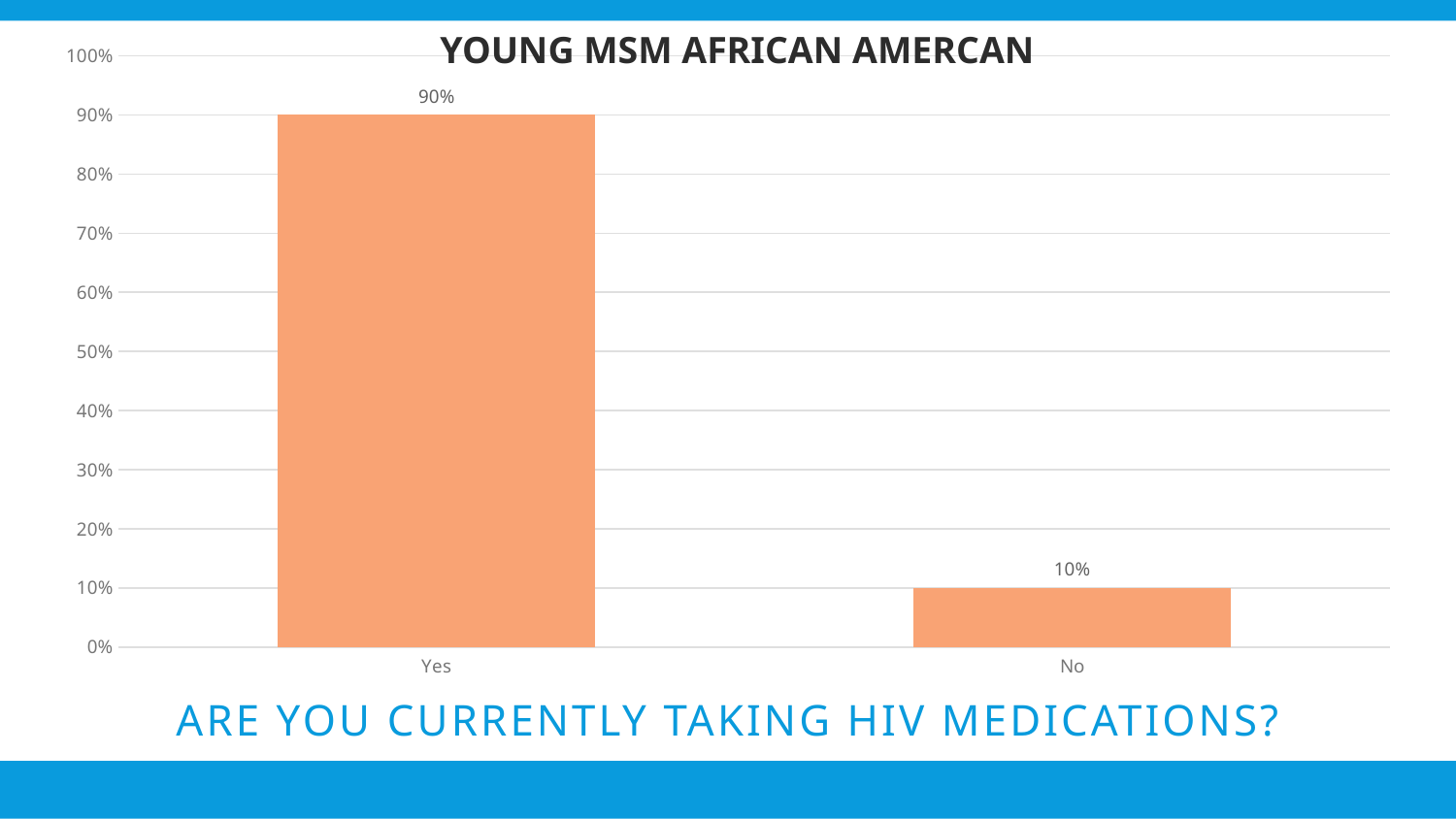
Which is larger, the value for Yes or the value for No? Yes What question is written below the chart? ARE YOU CURRENTLY TAKING HIV MEDICATIONS? How many categories are shown on the x axis? 2 What is the value for Yes? 90% Is the value for Yes greater or less than 50%? greater Which category has the highest value? Yes What is the value for No? 10% What is the difference between the values for Yes and No? 80% What kind of chart is shown on the slide? bar chart What is the title of the chart? YOUNG MSM AFRICAN AMERCAN Which category has the lowest value? No Is the value for No greater or less than 20%? less